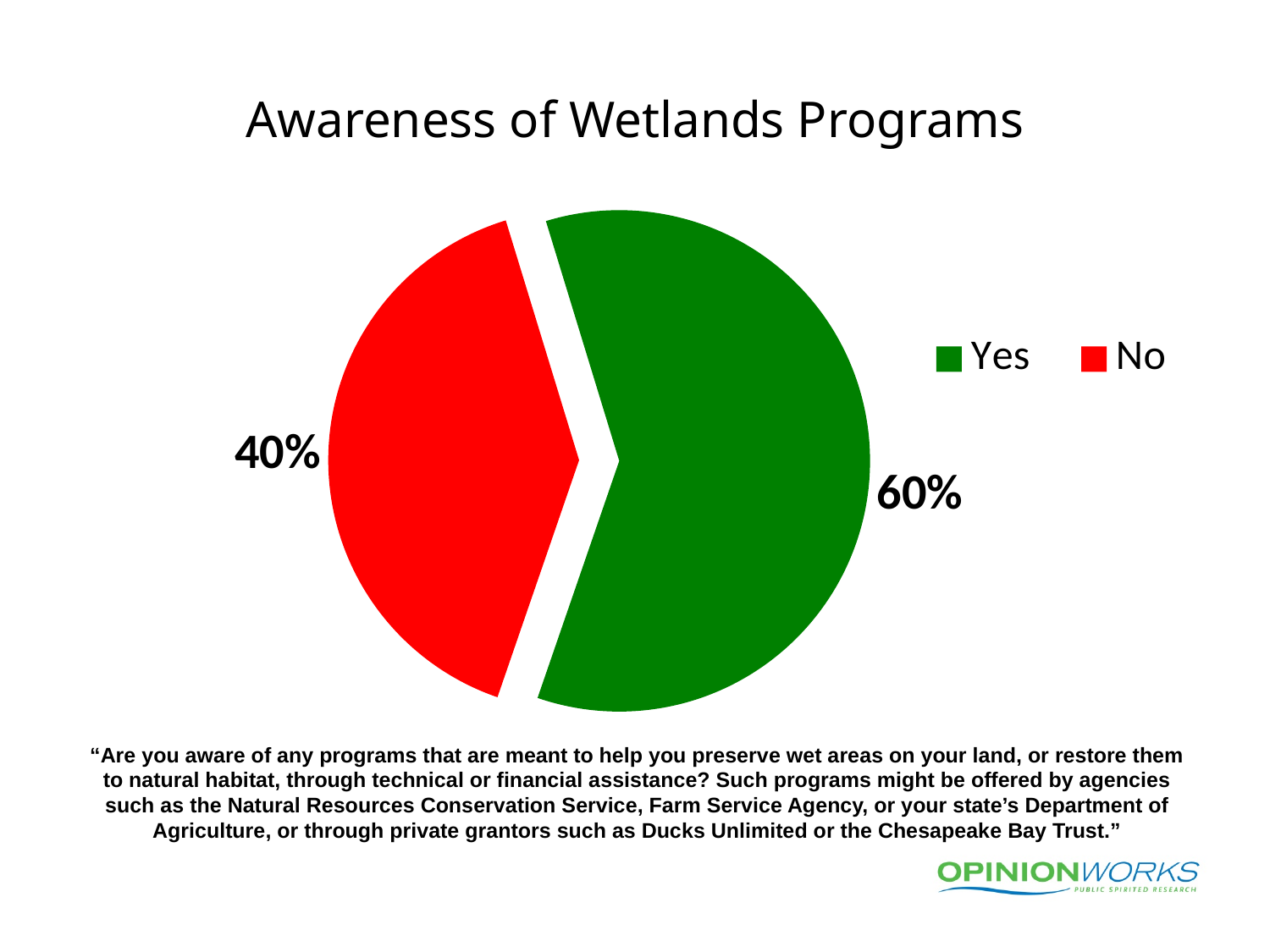
What kind of chart is shown on the slide? pie chart Is the share for No greater or less than 50%? less How many slices does the pie chart have? 2 What colour is the Yes slice? green Which response has the smallest share of the pie? No What percentage of respondents answered Yes? 60% What is the difference in percentage points between the Yes and No slices? 20 What is the title of the chart? Awareness of Wetlands Programs Which response has the largest share of the pie? Yes Which slice is larger, Yes or No? Yes What percentage of respondents answered No? 40% How many entries does the legend list? 2